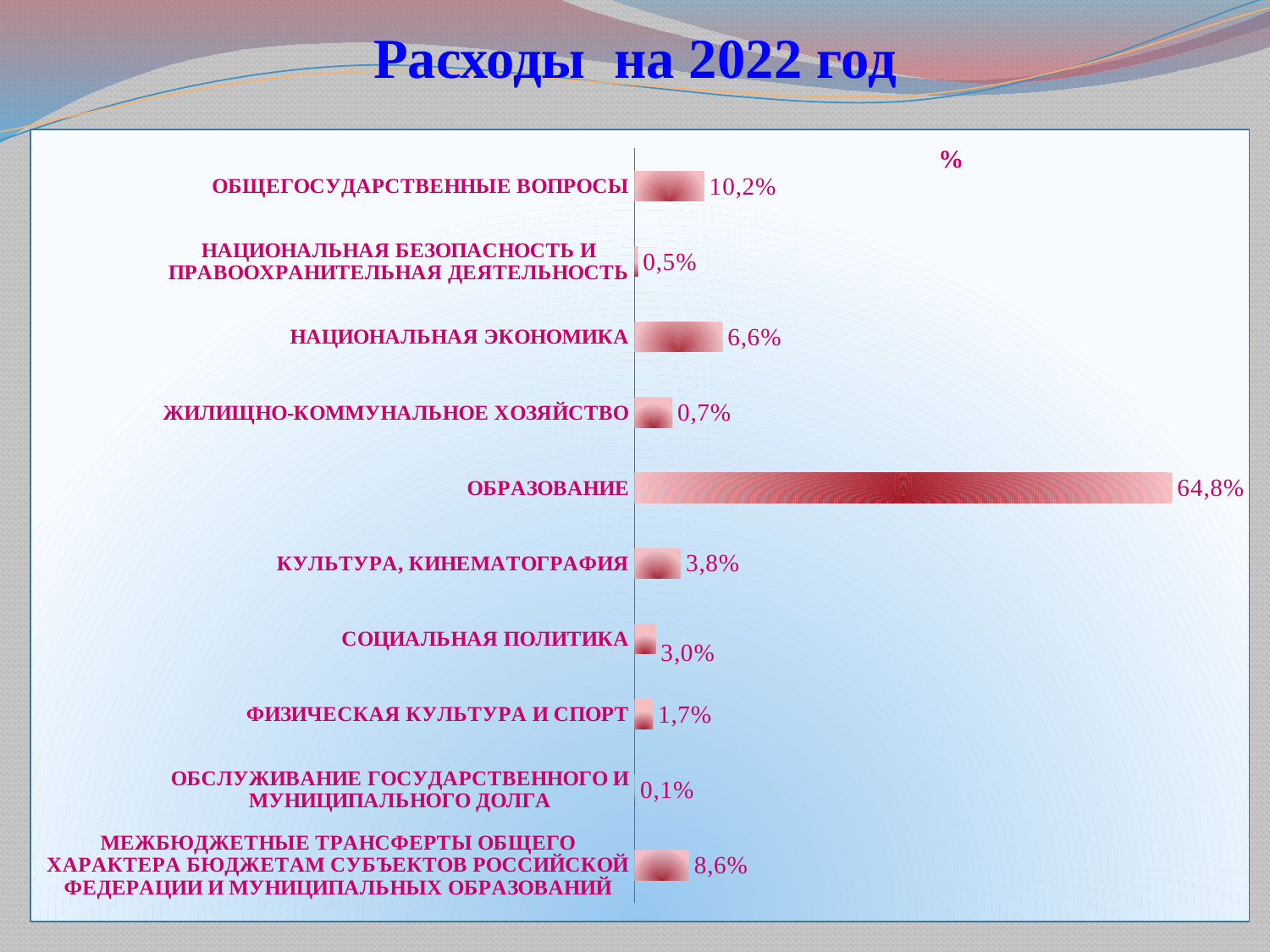
What is the value for НАЦИОНАЛЬНАЯ ЭКОНОМИКА? 6,6% What is the difference between the values for ОБЩЕГОСУДАРСТВЕННЫЕ ВОПРОСЫ and НАЦИОНАЛЬНАЯ ЭКОНОМИКА? 3,6% What kind of chart is shown on the slide? Bar chart What is the title of the slide? Расходы на 2022 год Which is larger: the value for КУЛЬТУРА, КИНЕМАТОГРАФИЯ or the value for СОЦИАЛЬНАЯ ПОЛИТИКА? КУЛЬТУРА, КИНЕМАТОГРАФИЯ How many categories are shown in the chart? 10 What is the value for ОБРАЗОВАНИЕ? 64,8% What is the difference between the values for ОБРАЗОВАНИЕ and МЕЖБЮДЖЕТНЫЕ ТРАНСФЕРТЫ ОБЩЕГО ХАРАКТЕРА БЮДЖЕТАМ СУБЪЕКТОВ РОССИЙСКОЙ ФЕДЕРАЦИИ И МУНИЦИПАЛЬНЫХ ОБРАЗОВАНИЙ? 56,2% Which category has the highest value? ОБРАЗОВАНИЕ Which category has the lowest value? ОБСЛУЖИВАНИЕ ГОСУДАРСТВЕННОГО И МУНИЦИПАЛЬНОГО ДОЛГА What is the value for ОБЩЕГОСУДАРСТВЕННЫЕ ВОПРОСЫ? 10,2% What is the value for ФИЗИЧЕСКАЯ КУЛЬТУРА И СПОРТ? 1,7%